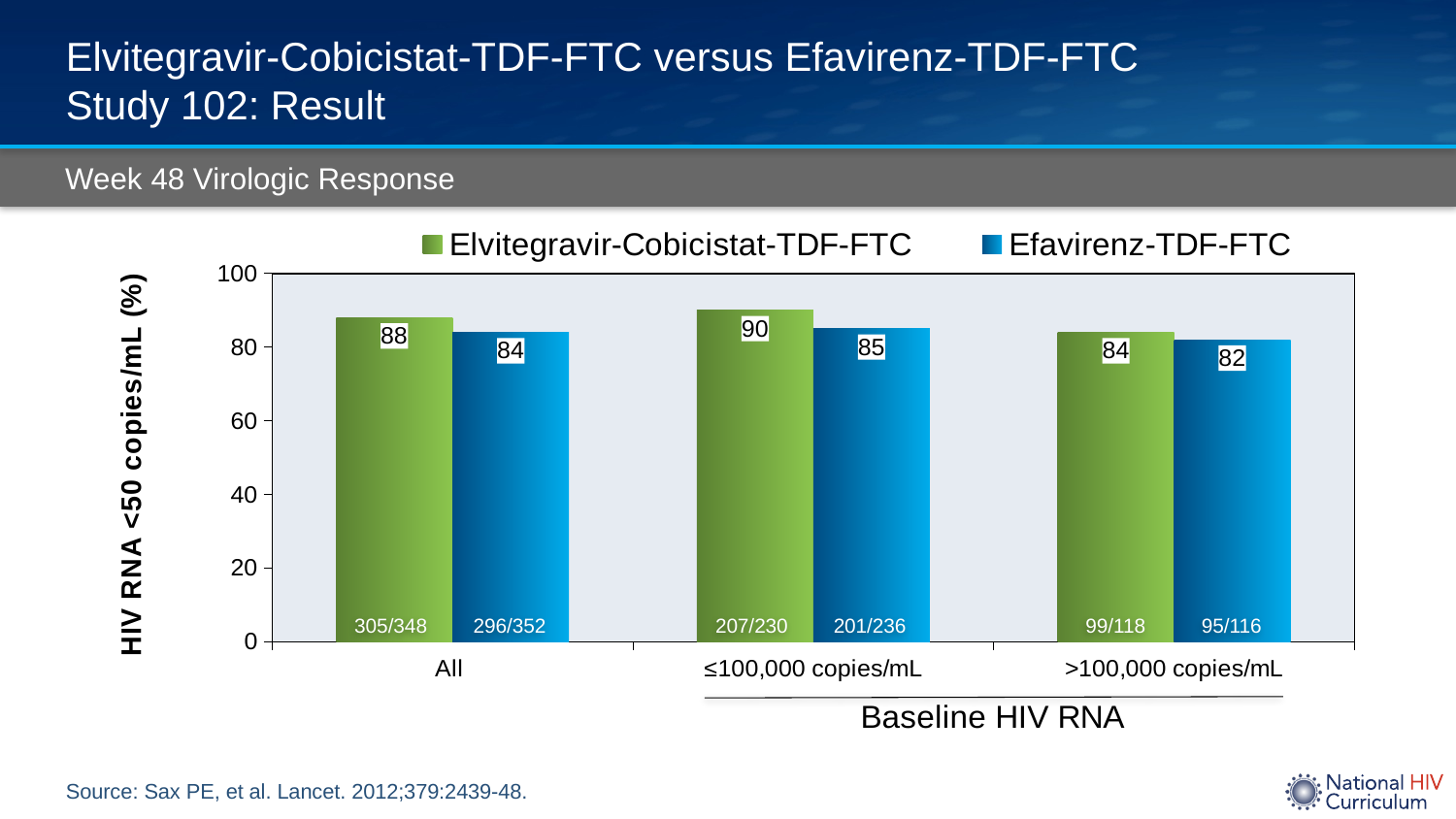
What kind of chart is shown on the slide? bar chart What is the difference between the Elvitegravir-Cobicistat-TDF-FTC and Efavirenz-TDF-FTC values in the All category? 4 Is the value for Efavirenz-TDF-FTC in the All category greater or less than 80? greater What is the value for Efavirenz-TDF-FTC in the ≤100,000 copies/mL category? 85 Which baseline HIV RNA category has the lowest value for Efavirenz-TDF-FTC? >100,000 copies/mL What is the value for Elvitegravir-Cobicistat-TDF-FTC in the All category? 88 Which baseline HIV RNA category has the highest value for Elvitegravir-Cobicistat-TDF-FTC? ≤100,000 copies/mL What is the value for Efavirenz-TDF-FTC in the >100,000 copies/mL category? 82 How many baseline HIV RNA categories are shown on the x axis? 3 How many series does the legend list? 2 In the ≤100,000 copies/mL category, which series has the larger value? Elvitegravir-Cobicistat-TDF-FTC What is the y-axis label of the chart? HIV RNA <50 copies/mL (%)